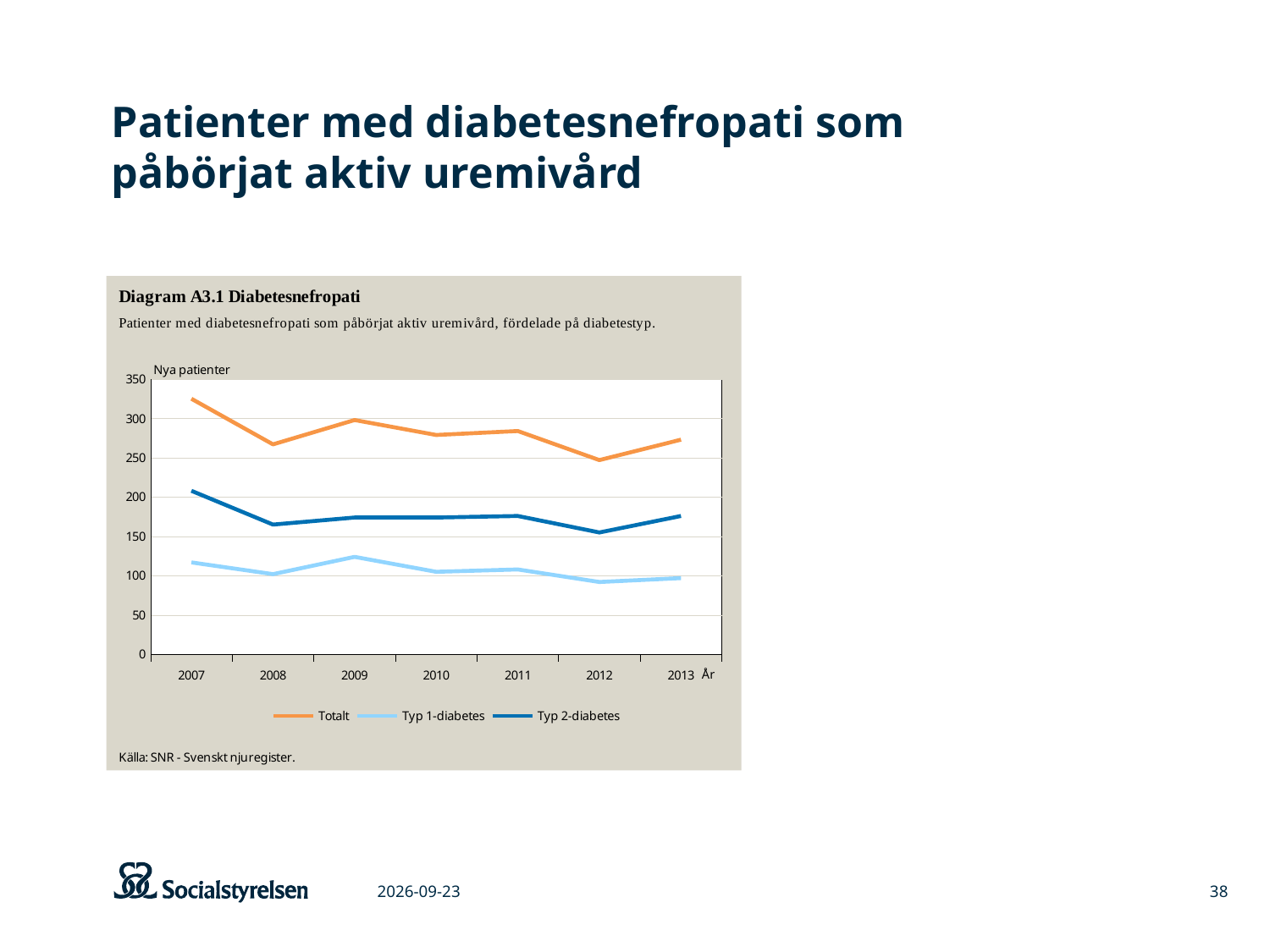
What is the label on the y axis? Nya patienter How many years are shown on the x axis? 7 In which year is the Totalt series highest? 2007 Is the value for Typ 1-diabetes in 2012 greater or less than 100? less In which year is the Typ 1-diabetes series highest? 2009 Is the value for Totalt in 2007 greater or less than 300? greater In which year is the Totalt series lowest? 2012 What kind of chart is shown in Diagram A3.1? line chart How many series does the legend list? 3 Which series has the larger value in 2010, Typ 1-diabetes or Typ 2-diabetes? Typ 2-diabetes In which year is the Typ 2-diabetes series highest? 2007